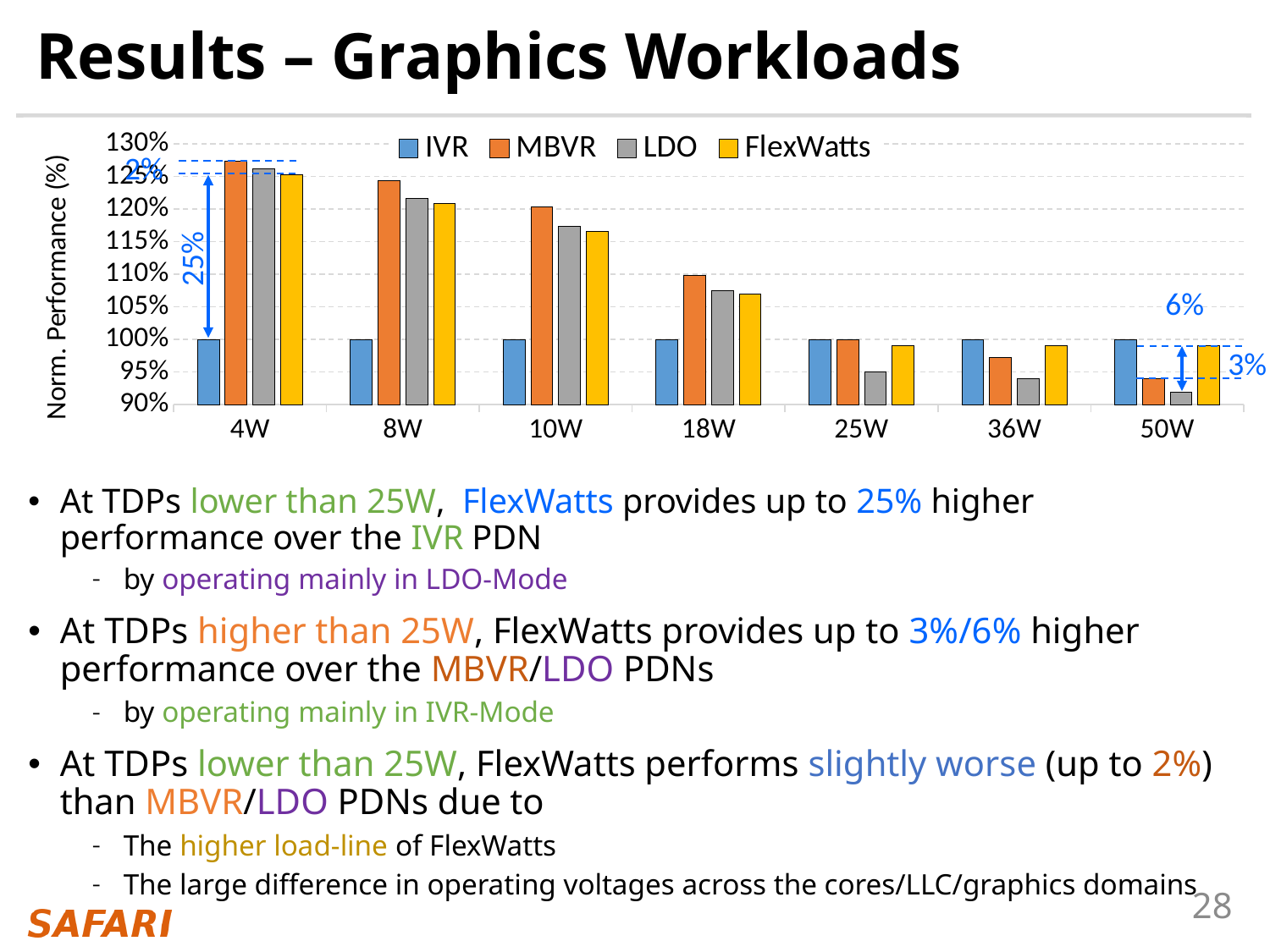
Is the value for LDO at 50W greater or less than 95%? less Do the MBVR values rise or fall as the TDP increases from 4W to 50W? fall What is the value of the IVR series at 4W? 100% What kind of chart is shown on the slide? bar chart Is the value for MBVR at 36W greater or less than 100%? less Is the value for MBVR at 8W greater or less than 120%? greater How many TDP categories are shown on the x axis of the chart? 7 What is the value of the IVR series at 18W? 100% Which series has the lowest value at 50W? LDO At 18W, which is larger: the MBVR value or the FlexWatts value? MBVR How many series does the chart legend list? 4